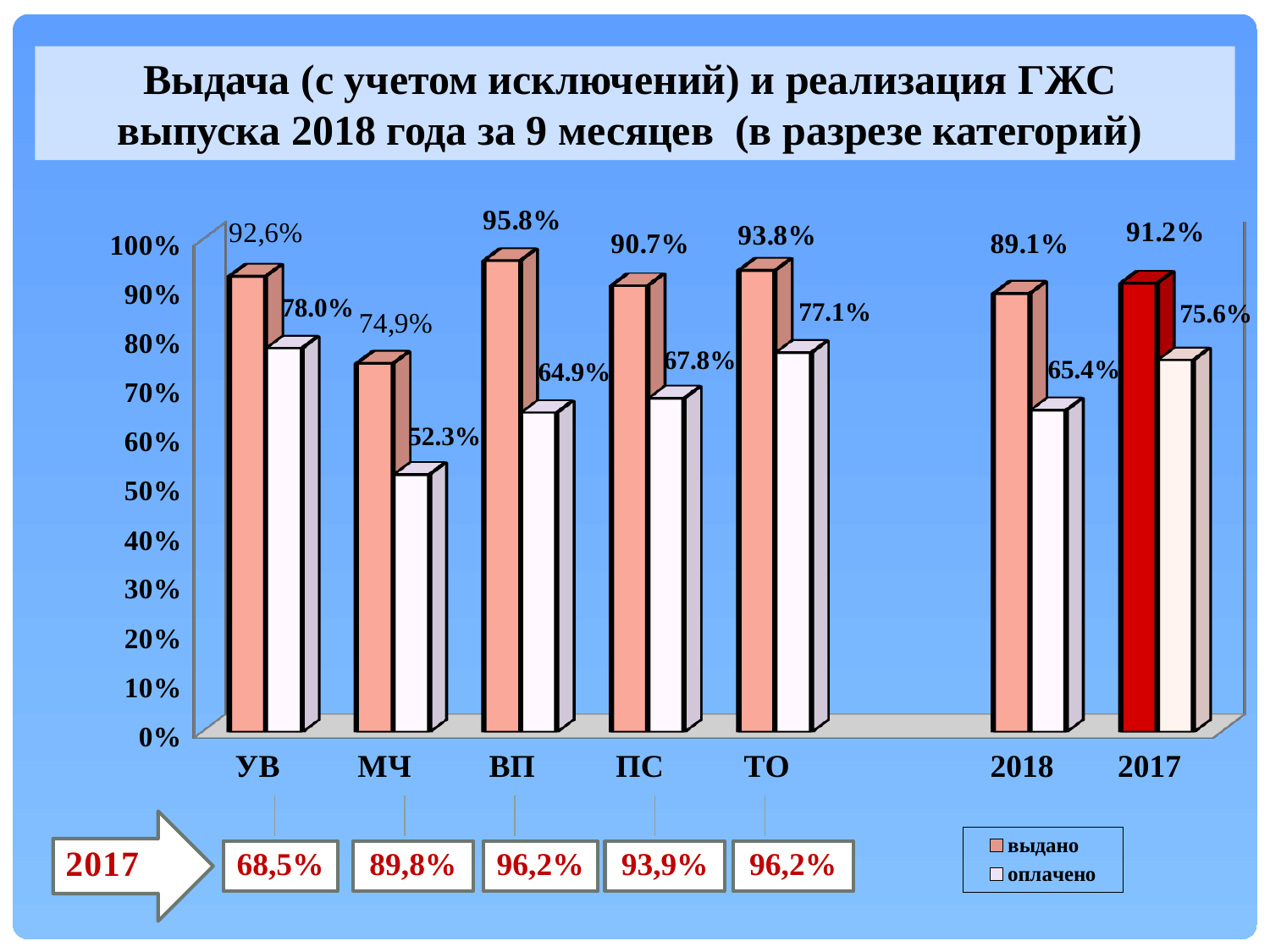
What kind of chart is shown on the slide? bar chart Which category has the lowest оплачено value? МЧ Which is larger, the оплачено value for УВ or the оплачено value for ПС? УВ What is the value of the оплачено bar for 2017? 75.6% What is the value of the выдано bar for УВ? 92,6% How many categories are shown on the x axis of the chart? 7 How many series does the legend list? 2 What are the two series named in the legend? выдано and оплачено What is the value of the выдано bar for ВП? 95.8% What is the difference between the выдано and оплачено values for ТО? 16.7% Which category has the highest выдано value? ВП What is the value of the оплачено bar for МЧ? 52.3%